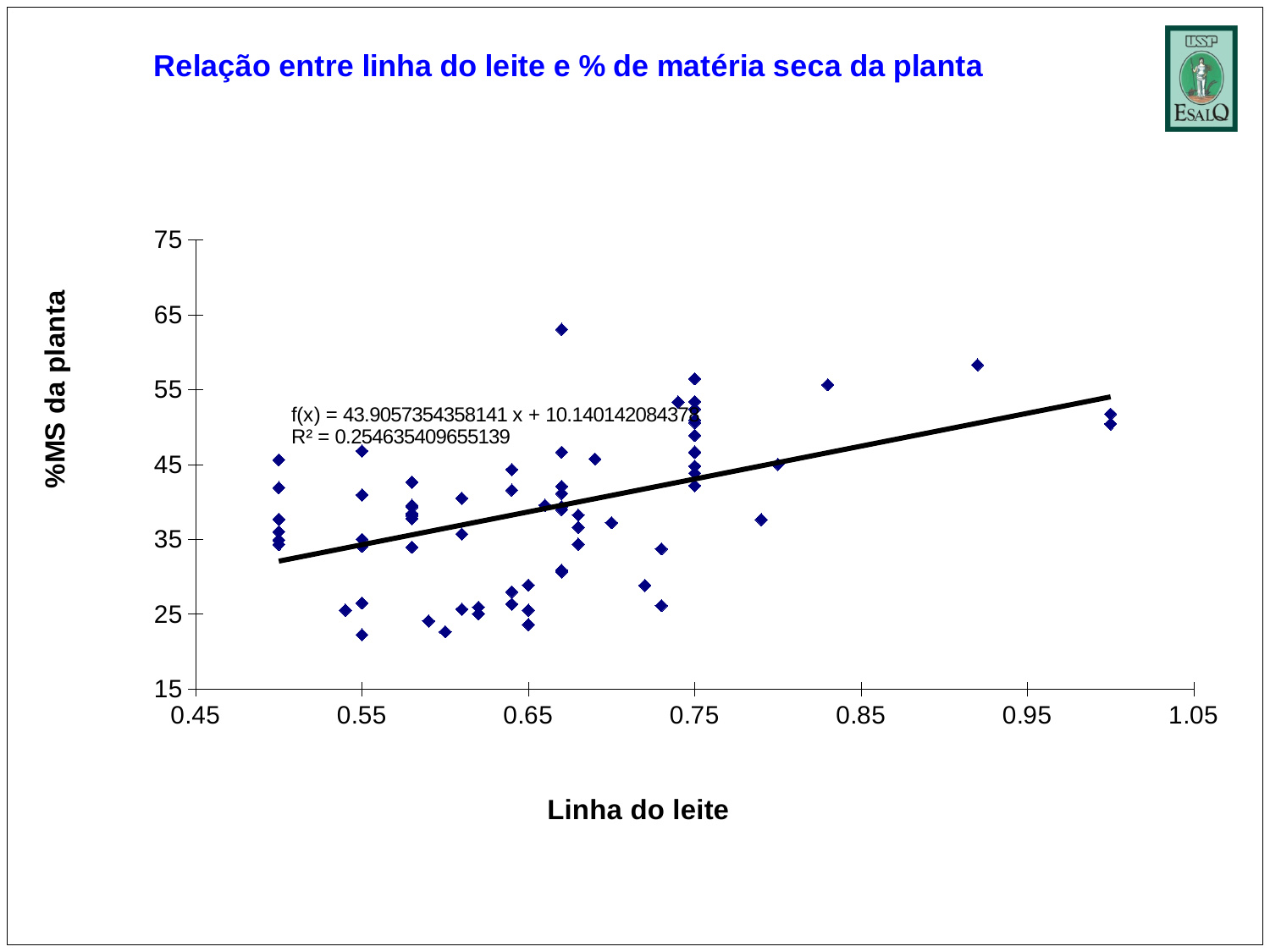
What is the slope (coefficient of x) in the fitted equation printed on the chart? 43.9057354358141 Is the %MS da planta value of the lowest plotted point greater or less than 25? less What kind of chart is shown on the slide? Scatter chart Is the %MS da planta value of the highest plotted point greater or less than 55? greater What is the title of the chart? Relação entre linha do leite e % de matéria seca da planta What R² value is printed on the chart? 0.254635409655139 What is the maximum value shown on the y axis? 75 Does the fitted trendline rise or fall as Linha do leite increases? Rises Is the %MS da planta value of the point at Linha do leite 0.92 greater or less than 55? greater What is the label of the x axis? Linha do leite